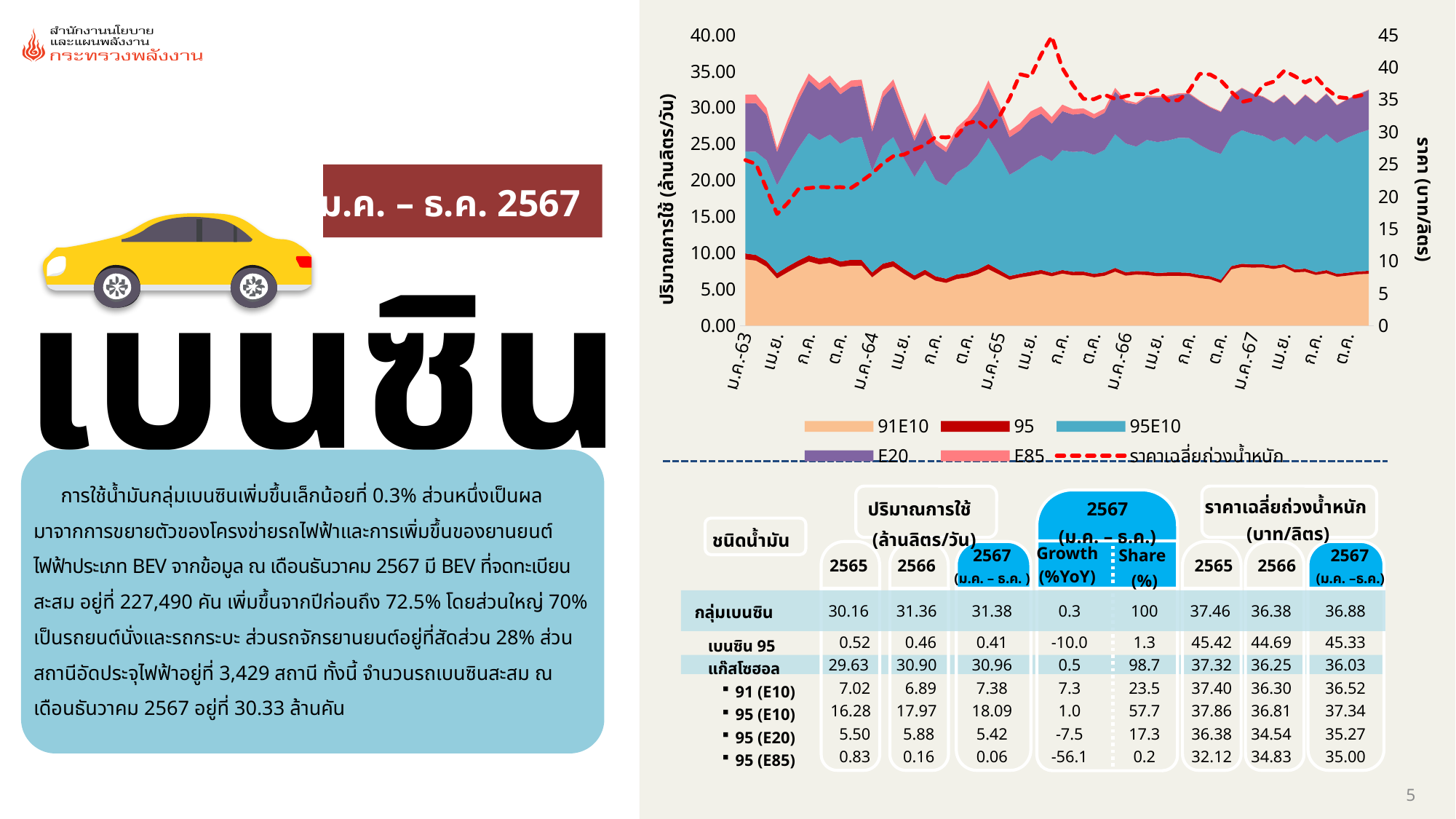
Is the 91E10 consumption at ต.ค.-67 greater or less than 10 on the left axis? less Is the total stacked consumption at ม.ค.-63 greater or less than 30 on the left axis? greater Around which x-axis label does the weighted average price line reach its lowest point? เม.ย.-63 What kind of chart is shown on the right side of the slide? A stacked area chart with a dashed line series What is the label of the left vertical axis of the chart? ปริมาณการใช้ (ล้านลิตร/วัน) Around which x-axis label does the weighted average price line reach its highest point? ก.ค.-65 Is the weighted average price (ราคาเฉลี่ยถ่วงน้ำหนัก) at เม.ย.-63 greater or less than 20 on the right axis? less Does the 95E10 band in the chart generally widen or narrow from ม.ค.-63 to ต.ค.-67? widen Which series in the chart is drawn as a red dashed line? ราคาเฉลี่ยถ่วงน้ำหนัก How many series does the chart legend list? 6 How many tick labels are shown along the x axis of the chart? 20